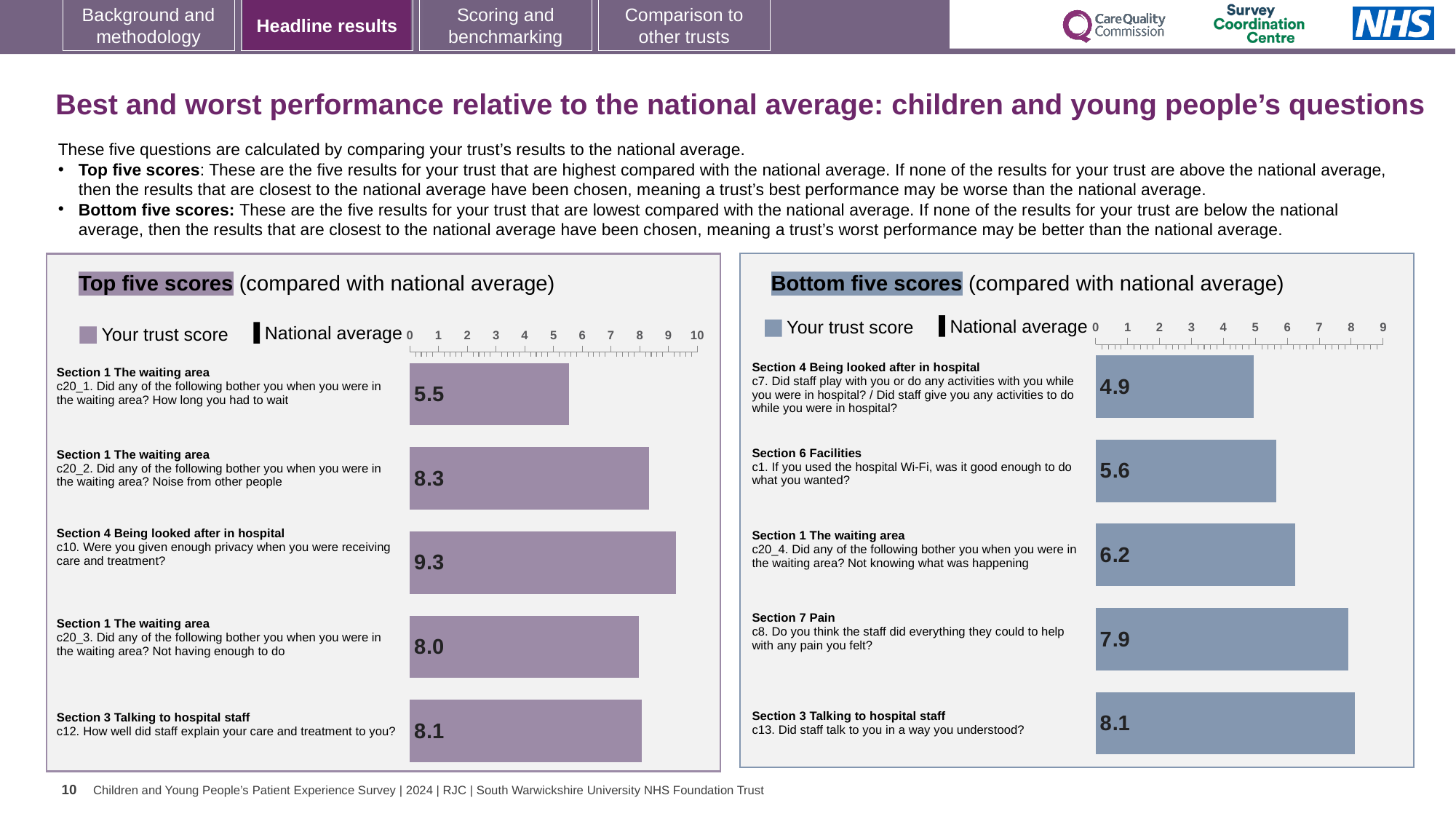
In the Bottom five scores chart, which question has the lowest trust score? c7. Did staff play with you or do any activities with you while you were in hospital? / Did staff give you any activities to do while you were in hospital? What type of chart is the Top five scores chart? Bar chart In the Top five scores chart, what is the trust score for c10 'Were you given enough privacy when you were receiving care and treatment?' 9.3 In the Top five scores chart, which question has the lowest trust score? c20_1. Did any of the following bother you when you were in the waiting area? How long you had to wait What two entries does the legend of the Bottom five scores chart list? Your trust score and National average In the Top five scores chart, which question has the highest trust score? c10. Were you given enough privacy when you were receiving care and treatment? In the Bottom five scores chart, what is the trust score for c1 'If you used the hospital Wi-Fi, was it good enough to do what you wanted?' 5.6 In the Bottom five scores chart, which question has the highest trust score? c13. Did staff talk to you in a way you understood? In the Top five scores chart, which has the larger trust score: c20_2 (noise from other people) or c20_3 (not having enough to do)? c20_2 (noise from other people) In the Bottom five scores chart, what is the difference between the trust score for c13 (staff talk in a way you understood) and c7 (staff play/activities)? 3.2 In the Top five scores chart, what is the difference between the trust score for c10 (privacy) and c20_1 (how long you had to wait)? 3.8 How many questions are shown in the Bottom five scores chart? 5